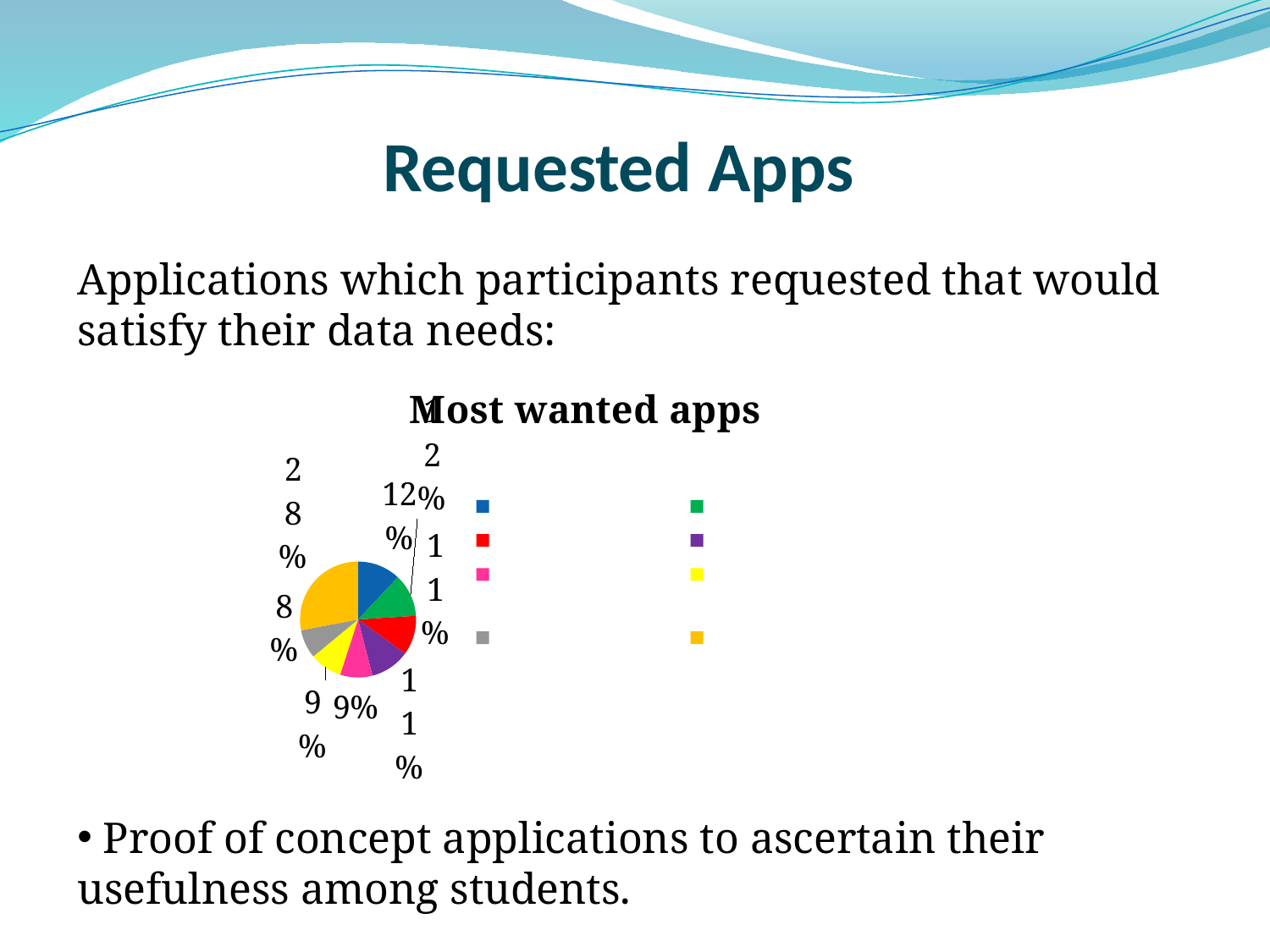
How many slices does the pie chart have? 8 What is the title of the chart? Most wanted apps What kind of chart is shown on the slide? pie chart Which colour slice is the largest in the pie chart? orange How many entries does the chart's legend list? 8 Is the orange slice larger or smaller than the blue slice? larger